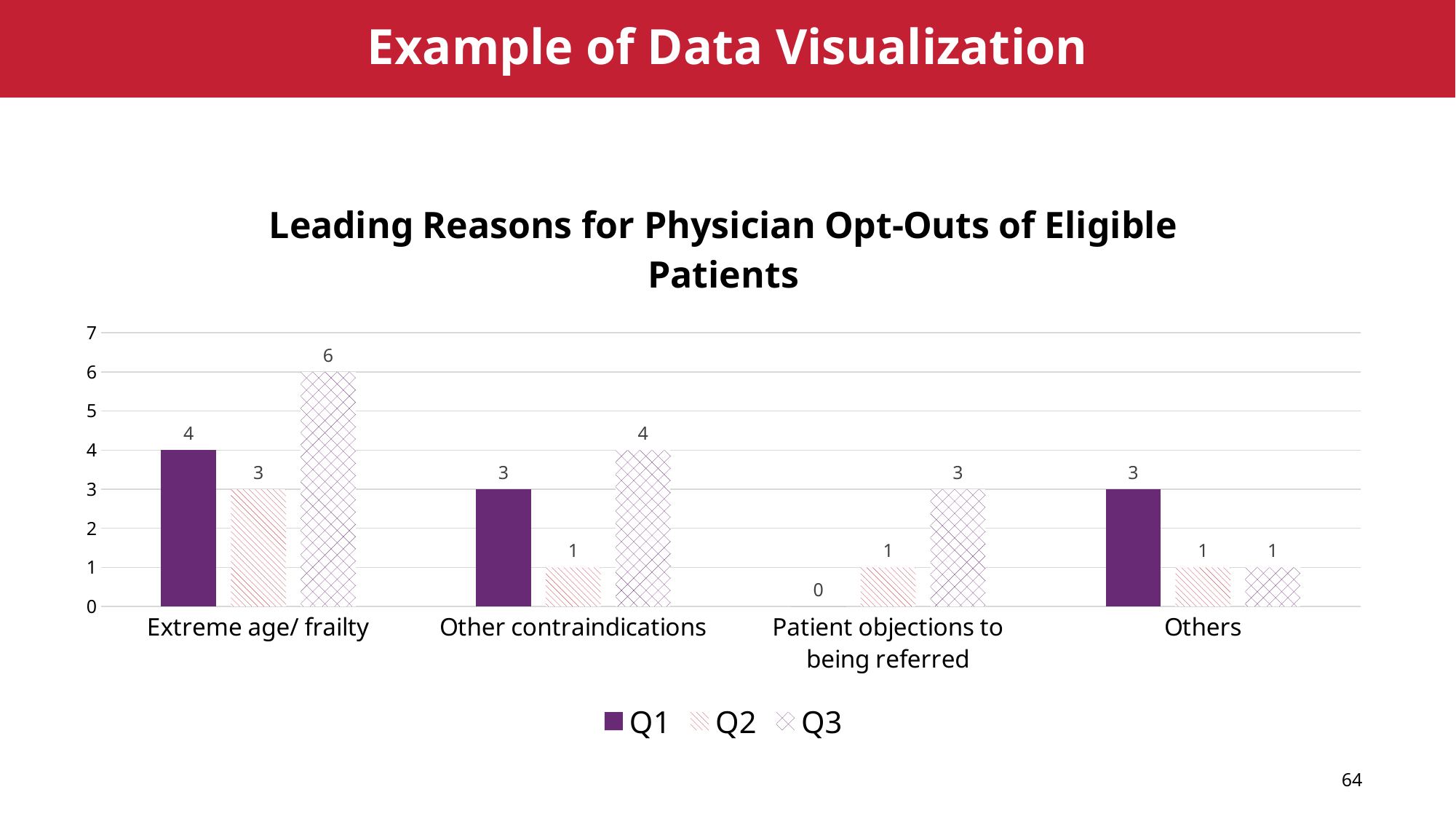
What is the Q2 value for Others? 1 Which category has the lowest Q1 value? Patient objections to being referred How many series does the legend list? 3 What is the Q3 value for Extreme age/ frailty? 6 What is the difference between the Q3 and Q1 values for Extreme age/ frailty? 2 How many categories are shown on the x axis? 4 Which category has the highest Q3 value? Extreme age/ frailty Which is larger for Other contraindications, the Q2 value or the Q3 value? Q3 What is the Q1 value for Patient objections to being referred? 0 What is the Q1 value for Other contraindications? 3 What is the title of the chart? Leading Reasons for Physician Opt-Outs of Eligible Patients What kind of chart is shown on the slide? Bar chart